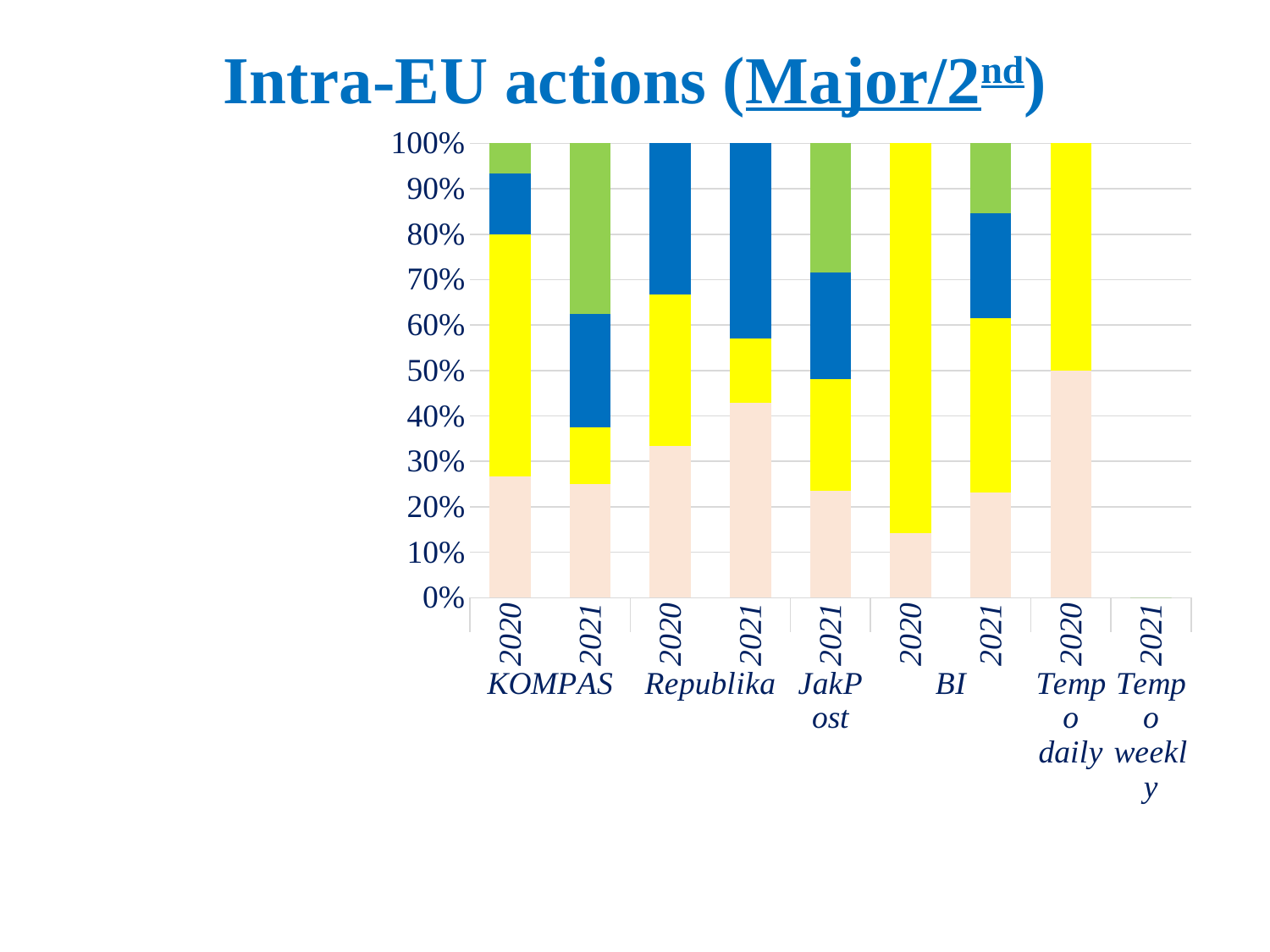
Does the BI 2020 bar contain a blue segment? No Which bar has the smallest bottom (peach) segment? BI 2020 How many year labels appear along the x axis of the chart? 9 Which bar has the largest bottom (peach) segment? Tempo daily 2020 Is the bottom (peach) segment of the BI 2020 bar greater or less than 20%? less What kind of chart is shown on the slide? Stacked bar chart What is the highest value shown on the y axis? 100% What is the title of the chart on the slide? Intra-EU actions (Major/2nd) Is the bottom (peach) segment of the Republika 2021 bar greater or less than 30%? greater Is the bottom (peach) segment of the Tempo daily 2020 bar greater or less than 40%? greater Which has the larger bottom (peach) segment, the Tempo daily 2020 bar or the BI 2020 bar? Tempo daily 2020